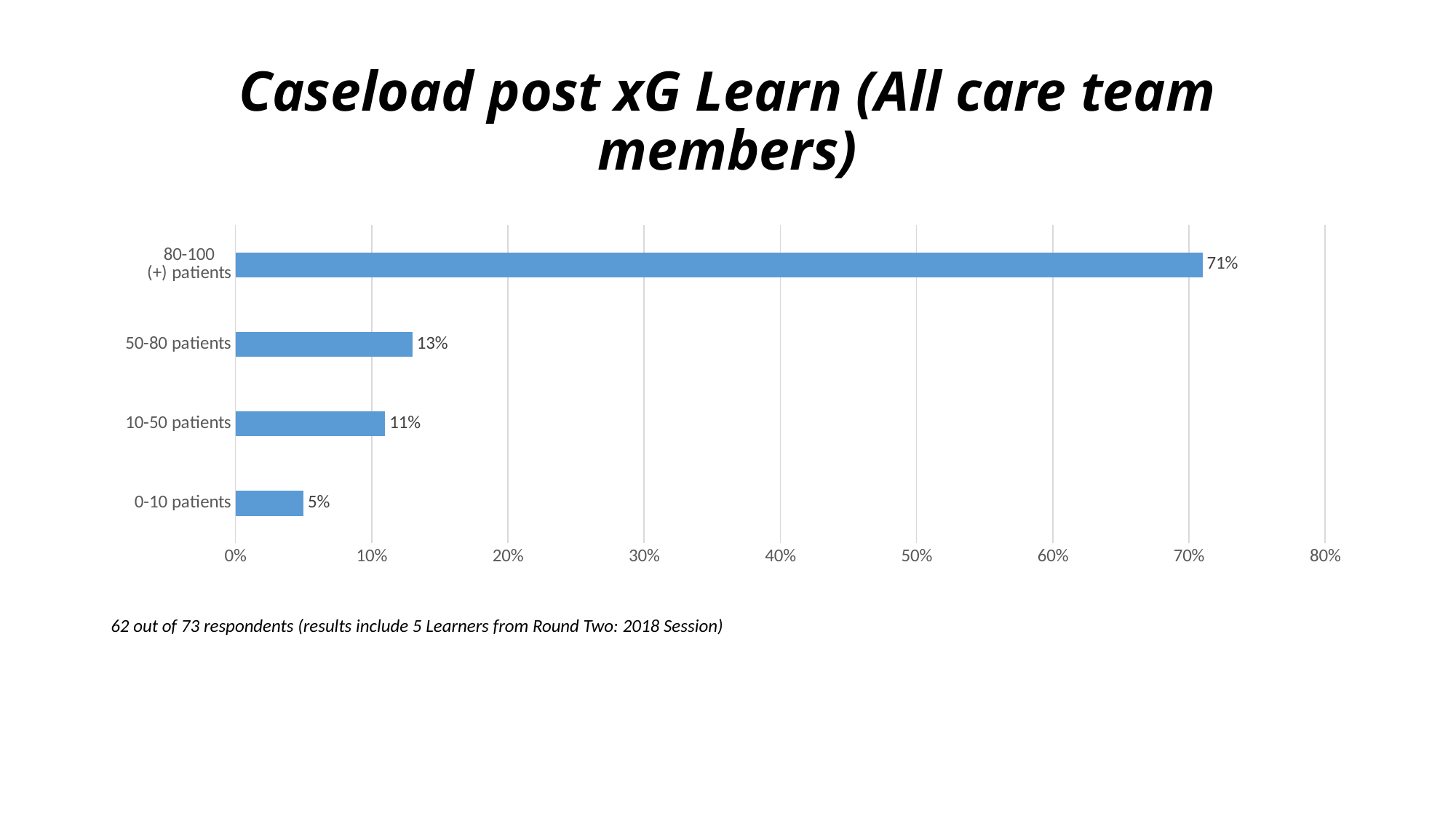
Is the value for 80-100 (+) patients greater or less than 60%? greater What kind of chart is shown on the slide? Bar chart What is the value for 80-100 (+) patients? 71% Which category has the lowest value? 0-10 patients Which is larger, the value for 50-80 patients or the value for 10-50 patients? 50-80 patients Which category has the highest value? 80-100 (+) patients What is the difference between the values for 80-100 (+) patients and 50-80 patients? 58% How many categories are shown in the chart? 4 What is the difference between the values for 10-50 patients and 0-10 patients? 6% What is the value for 50-80 patients? 13% What is the value for 0-10 patients? 5% What is the value for 10-50 patients? 11%